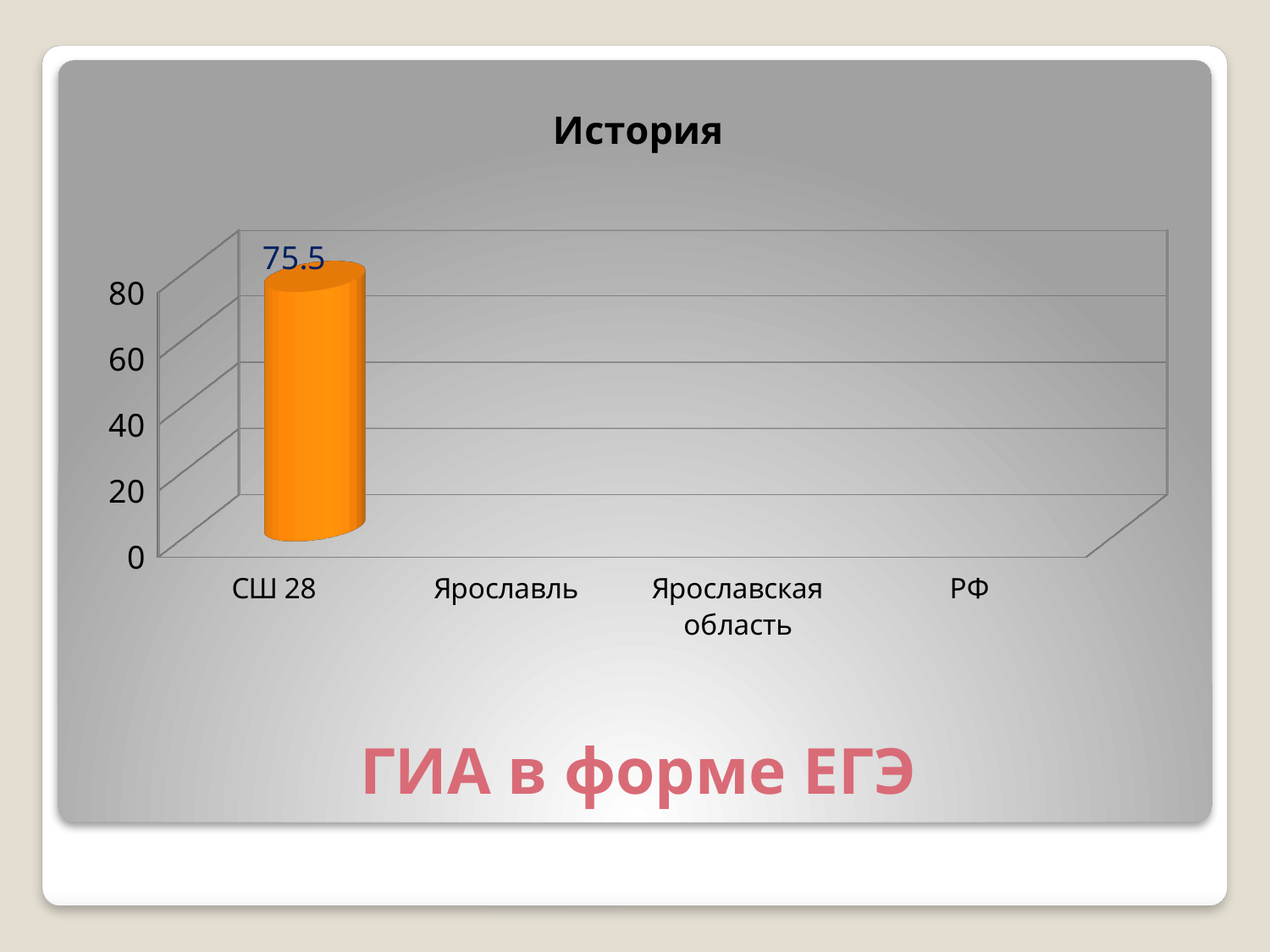
How many categories are listed on the x axis of the chart? 4 Is the value for СШ 28 greater or less than 60? greater Which category is listed last on the x axis? РФ What is the title of the chart? История What colour is the bar for СШ 28? orange Which category has the highest value in the chart? СШ 28 What kind of chart is shown on the slide? bar chart What is the value for СШ 28 in the chart? 75.5 Is the value for СШ 28 greater or less than 80? less